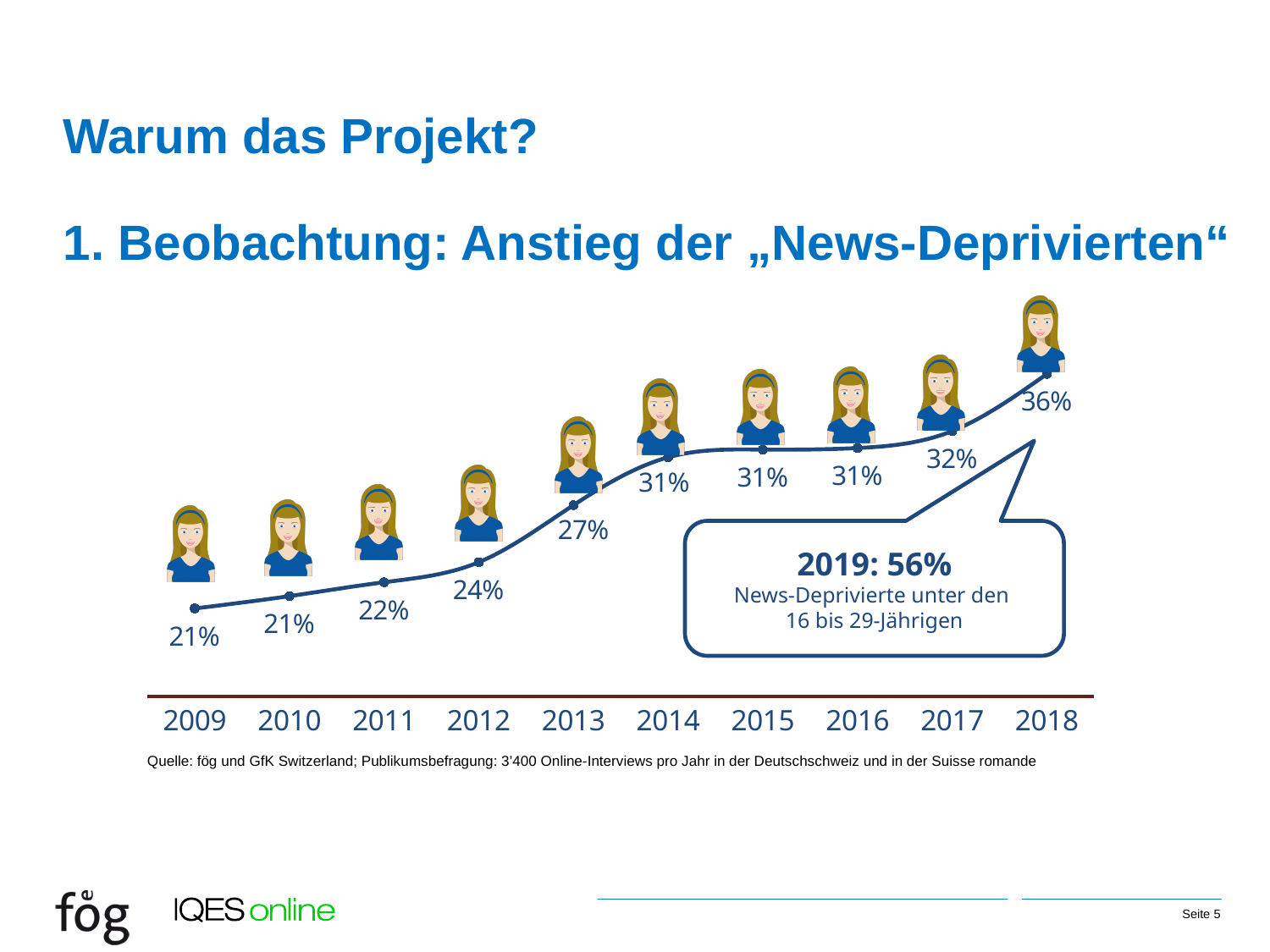
What is the difference between the values for 2018 and 2009? 15 percentage points What is the lowest value shown on the chart? 21% Which is larger, the value for 2017 or the value for 2012? 2017 What is the value for 2012? 24% What is the difference between the values for 2014 and 2013? 4 percentage points What is the value for 2018? 36% How many years are shown on the x axis? 10 What kind of chart is this? Line chart Do the values generally rise or fall from 2009 to 2018? Rise What is the value for 2013? 27% Which year has the highest value? 2018 According to the callout box, what share of 16 to 29-year-olds were news-deprived in 2019? 56%